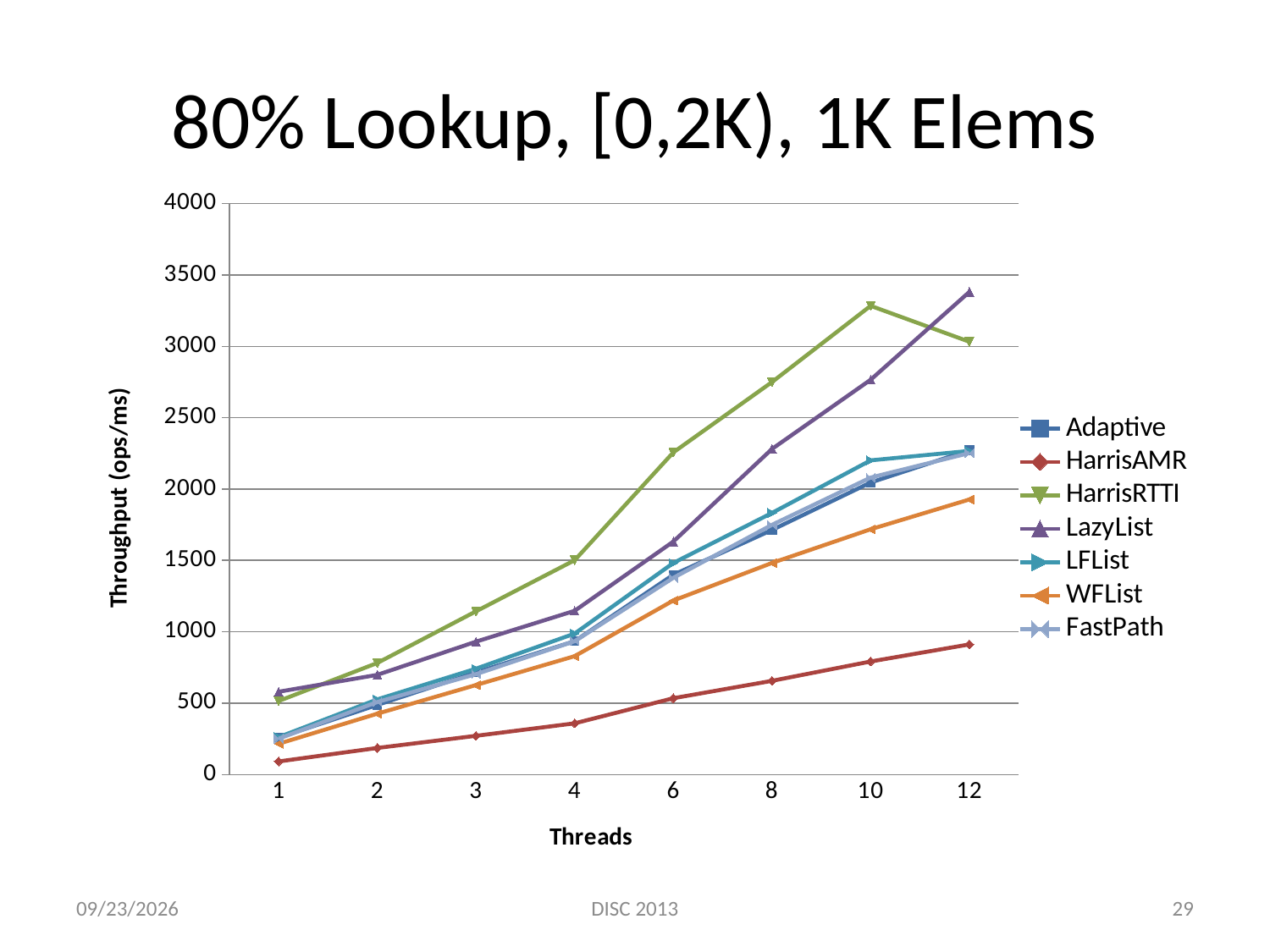
What kind of chart is shown on the slide? line chart What is the label of the y axis? Throughput (ops/ms) At 4 threads, which is larger: HarrisRTTI or LazyList? HarrisRTTI Does the throughput of HarrisRTTI rise or fall between 10 and 12 threads? fall Which series has the lowest throughput at 12 threads? HarrisAMR Which series has the highest throughput at 10 threads? HarrisRTTI How many thread counts are plotted along the x axis? 8 Is the value for HarrisRTTI at 10 threads greater or less than 3000? greater Is the value for WFList at 12 threads greater or less than 1500? greater Is the value for HarrisAMR at 12 threads greater or less than 1000? less Which series has the highest throughput at 12 threads? LazyList How many series does the legend list? 7